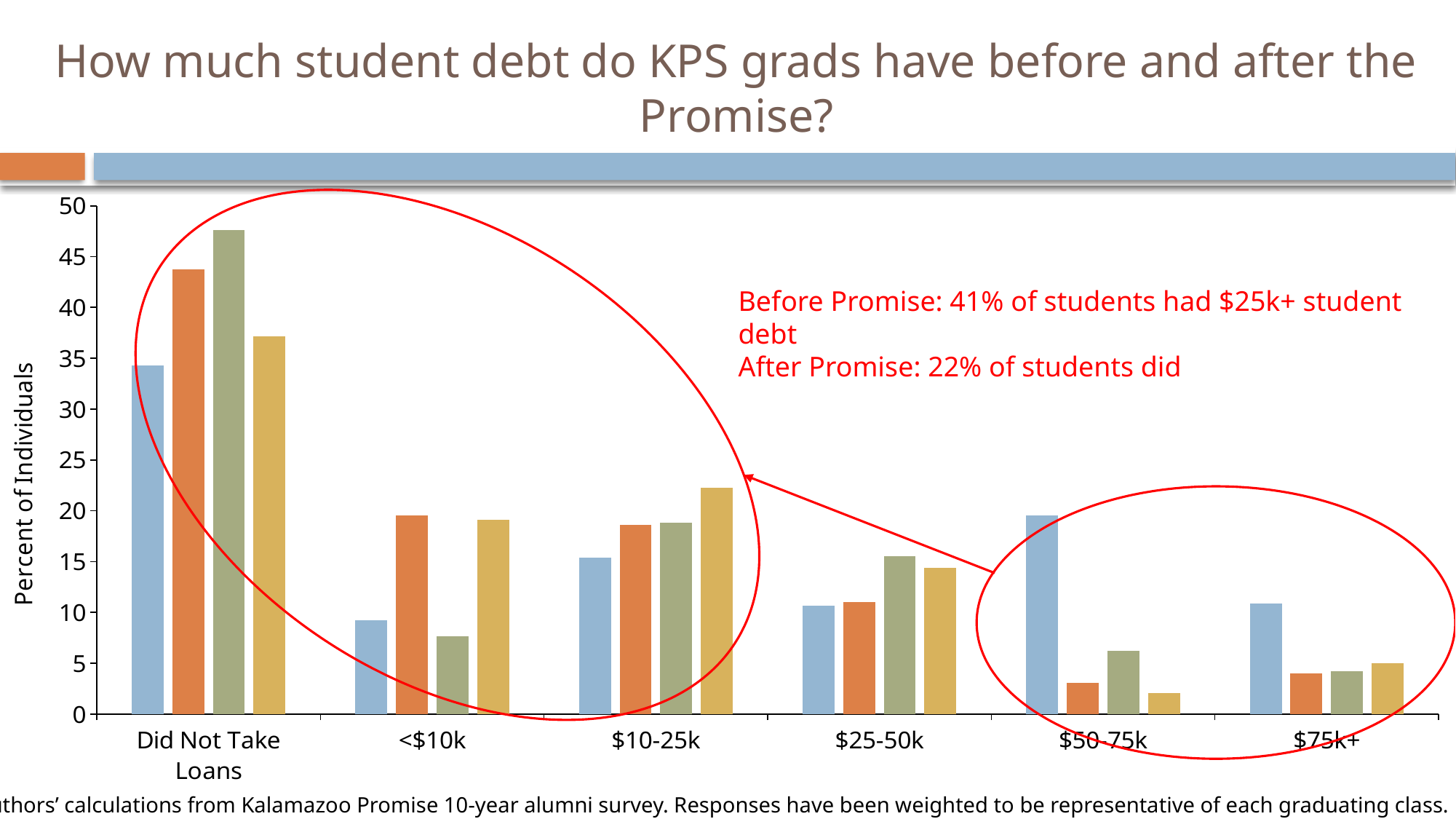
In the 'Did Not Take Loans' group, which bar is taller: the blue bar or the orange bar? the orange bar Is the value of the gold bar for '$10-25k' greater or less than 20? greater Is the value of the blue bar for 'Did Not Take Loans' greater or less than 30? greater Which category on the x axis contains the tallest bar in the chart? Did Not Take Loans Is the value of the green bar for '<$10k' greater or less than 10? less What is the label of the y axis? Percent of Individuals According to the red annotation, what percent of students had $25k+ student debt before the Promise? 41% In the '$50-75k' group, which bar is taller: the blue bar or the orange bar? the blue bar How many debt categories are shown along the x axis? 6 What kind of chart is shown on the slide? bar chart